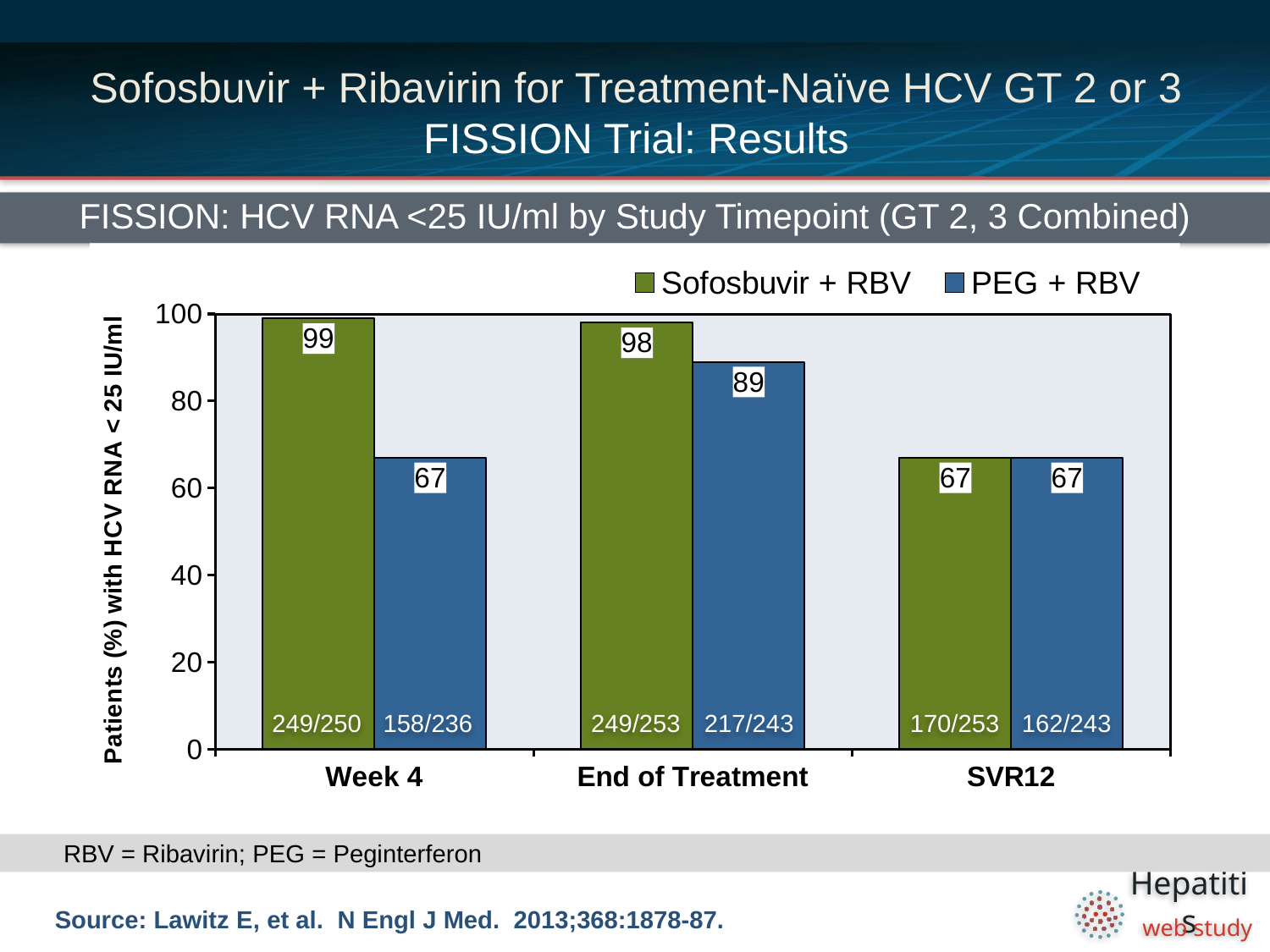
Does the Sofosbuvir + RBV value rise or fall from Week 4 to SVR12? Fall At which timepoint is the PEG + RBV value lowest? Week 4 and SVR12 (tied at 67) At which timepoint is the Sofosbuvir + RBV value highest? Week 4 What is the value for PEG + RBV at End of Treatment? 89 What fraction of patients is shown for PEG + RBV at Week 4? 158/236 What kind of chart is shown? Bar chart What is the value for Sofosbuvir + RBV at Week 4? 99 What is the difference between Sofosbuvir + RBV and PEG + RBV at Week 4? 32 How many timepoints are shown on the x axis? 3 Which series has the larger value at End of Treatment, Sofosbuvir + RBV or PEG + RBV? Sofosbuvir + RBV How many series does the legend list? 2 What is the value for Sofosbuvir + RBV at SVR12? 67